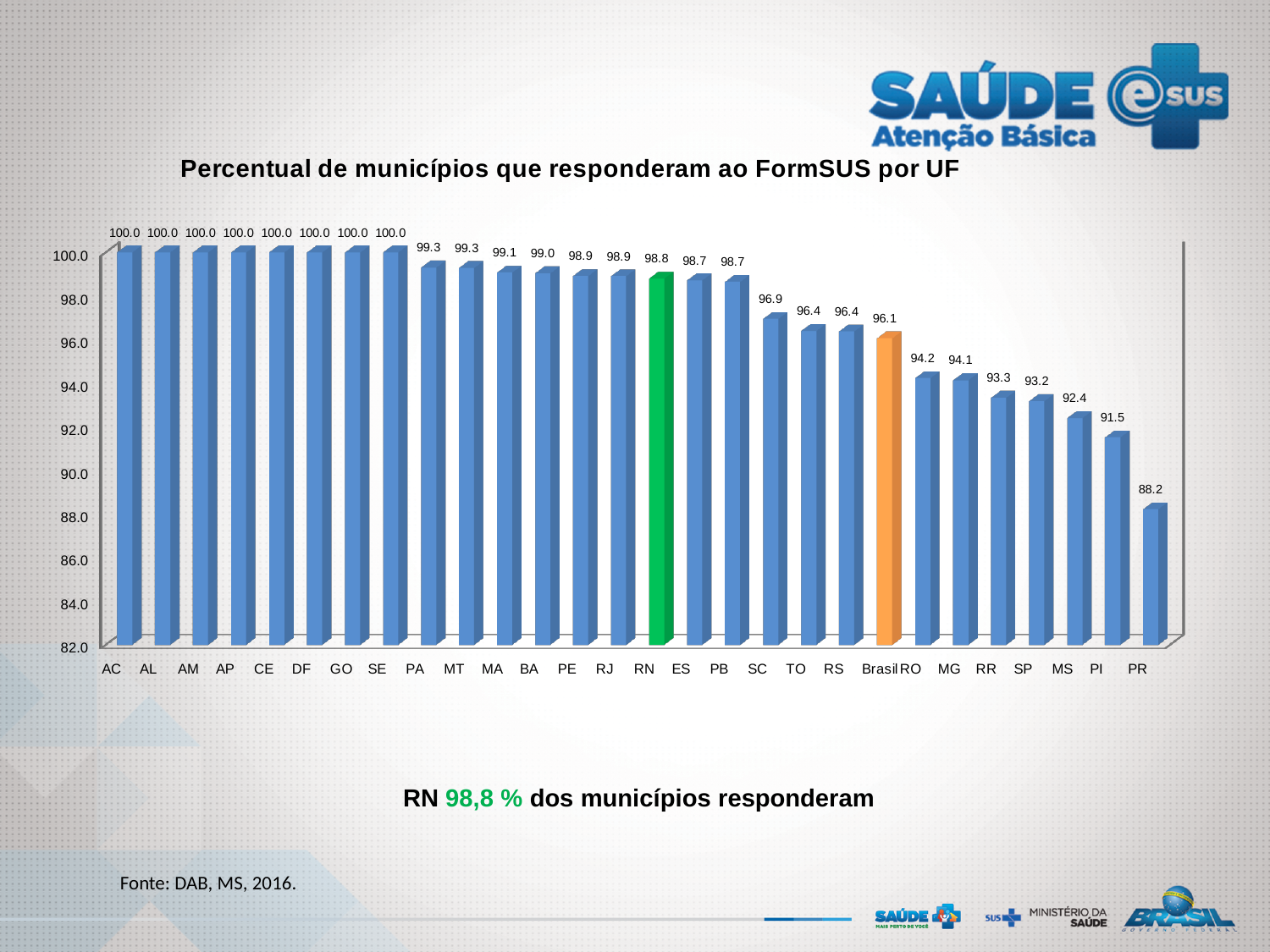
What is the value for RN? 98.8 How many bars are plotted in the chart? 28 What is the value for SC? 96.9 What is the difference between the values for PI and PR? 3.3 What is the value for Brasil? 96.1 Which is larger, the value for MG or the value for SP? MG What is the difference between the values for RN and Brasil? 2.7 Do the values rise or fall from left to right along the x axis? Fall Which bar is coloured green? RN What kind of chart is shown on the slide? Bar chart What is the value for PR? 88.2 Which category has the lowest value? PR